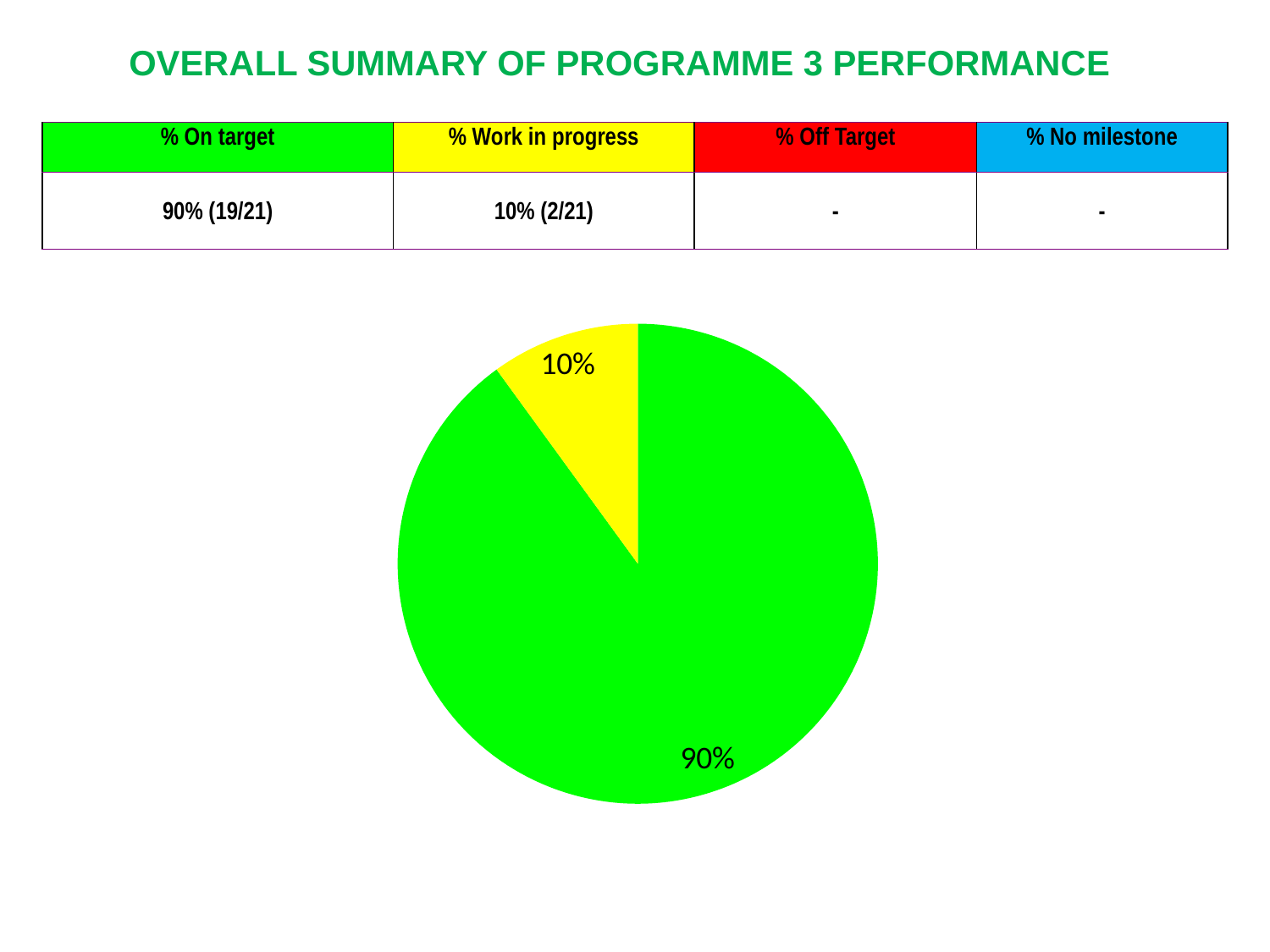
What kind of chart is shown on the slide? pie chart According to the table colour coding on the slide, which status does the green slice of the pie chart represent? % On target Which slice of the pie chart is the smallest? the yellow slice (10%) What is the difference in percentage points between the green slice and the yellow slice of the pie chart? 80 Which slice of the pie chart is the largest? the green slice (90%) Which is larger in the pie chart, the green slice or the yellow slice? the green slice What share of the pie does the yellow slice represent? 10% How many slices does the pie chart have? 2 According to the table colour coding on the slide, which status does the yellow slice of the pie chart represent? % Work in progress What percentage is shown on the green slice of the pie chart? 90% What percentage is shown on the yellow slice of the pie chart? 10% Is the value of the green slice in the pie chart greater or less than 50%? greater